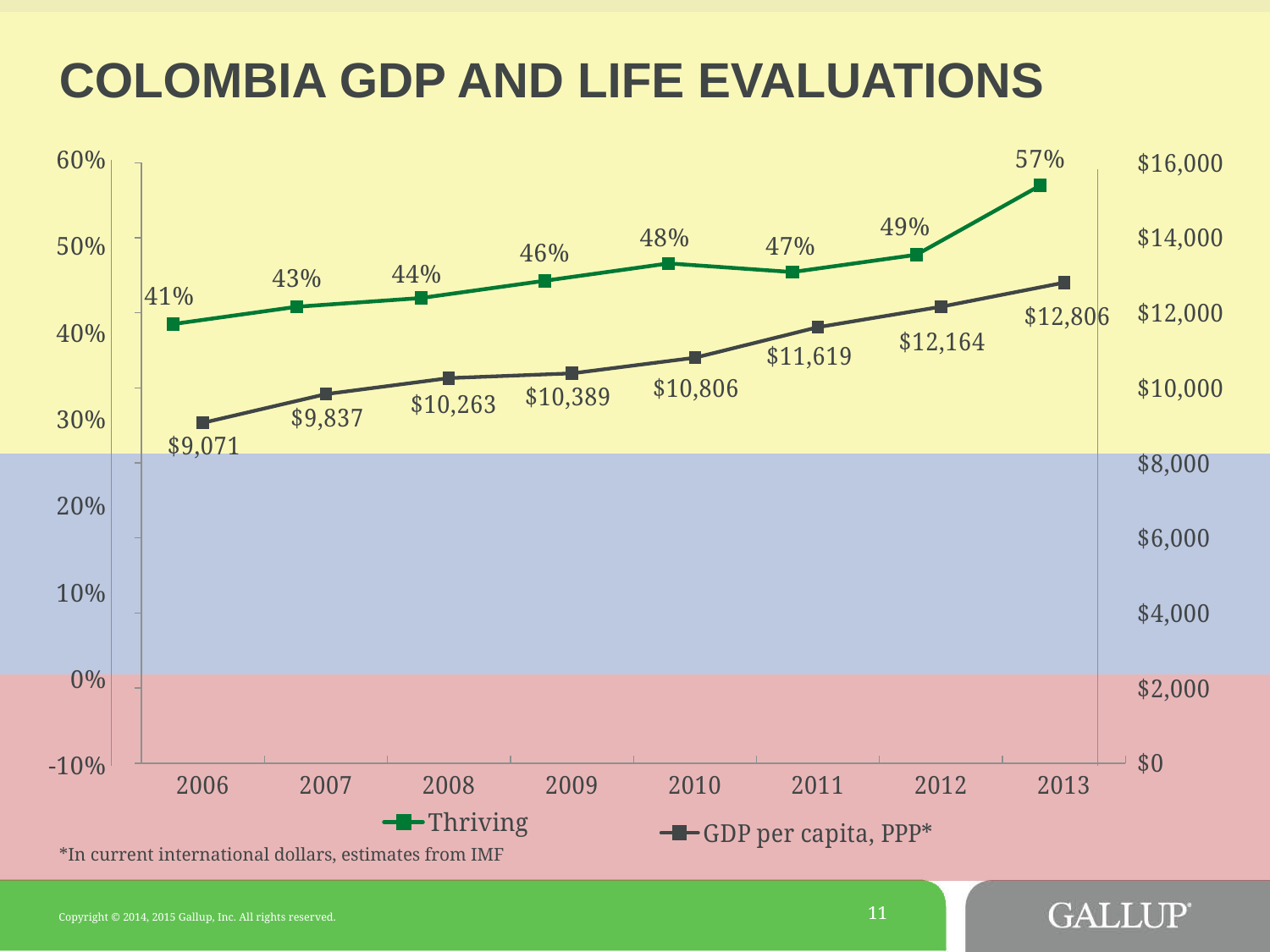
What kind of chart is shown on the slide? Line chart What is the GDP per capita, PPP value for 2013? $12,806 Does the GDP per capita, PPP series rise or fall from 2006 to 2013? Rise What is the Thriving percentage for 2006? 41% How many years are shown on the x axis? 8 What is the Thriving percentage for 2011? 47% In which year is the Thriving percentage highest? 2013 How many series does the legend list? 2 Which year has a higher Thriving percentage, 2010 or 2011? 2010 What is the GDP per capita, PPP value for 2010? $10,806 In which year is the GDP per capita, PPP value lowest? 2006 What is the difference in Thriving percentage between 2013 and 2006? 16%